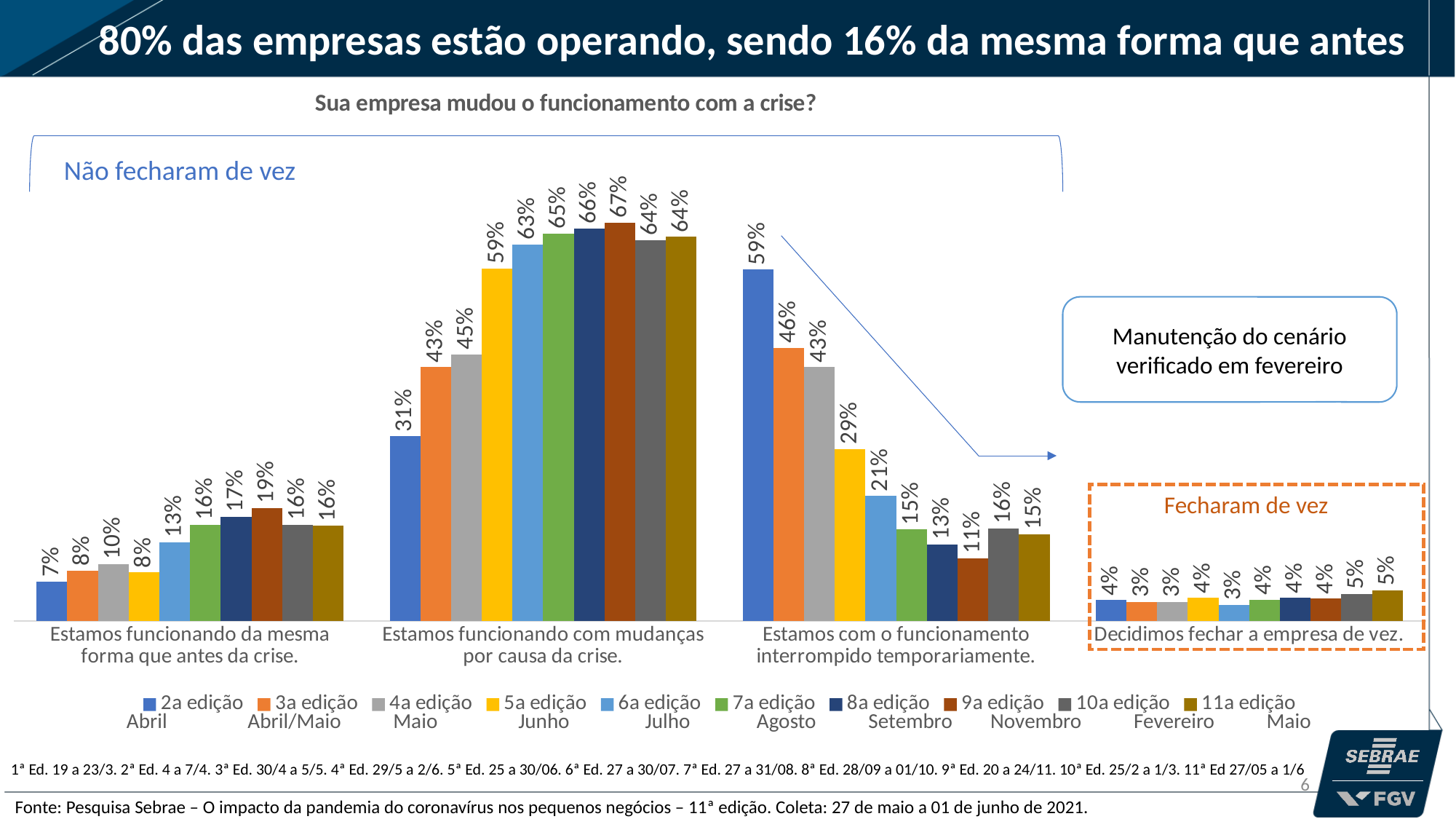
What is the value for the 9a edição series in the category 'Estamos funcionando com mudanças por causa da crise.'? 67% In the category 'Decidimos fechar a empresa de vez.', which is larger: the 2a edição value or the 11a edição value? 11a edição How many series does the legend list? 10 How many categories are shown on the x axis? 4 Which series has the lowest value in the category 'Estamos funcionando da mesma forma que antes da crise.'? 2a edição What is the value for the 2a edição series in the category 'Estamos com o funcionamento interrompido temporariamente.'? 59% Which series has the highest value in the category 'Estamos funcionando com mudanças por causa da crise.'? 9a edição What is the difference between the 2a edição and 11a edição values in the category 'Estamos com o funcionamento interrompido temporariamente.'? 44% What is the value for the 11a edição series in the category 'Estamos funcionando da mesma forma que antes da crise.'? 16% Across the editions from 2a to 9a, do the values in the category 'Estamos com o funcionamento interrompido temporariamente.' rise or fall? Fall What is the title of the chart? Sua empresa mudou o funcionamento com a crise? What type of chart is shown on the slide? Bar chart